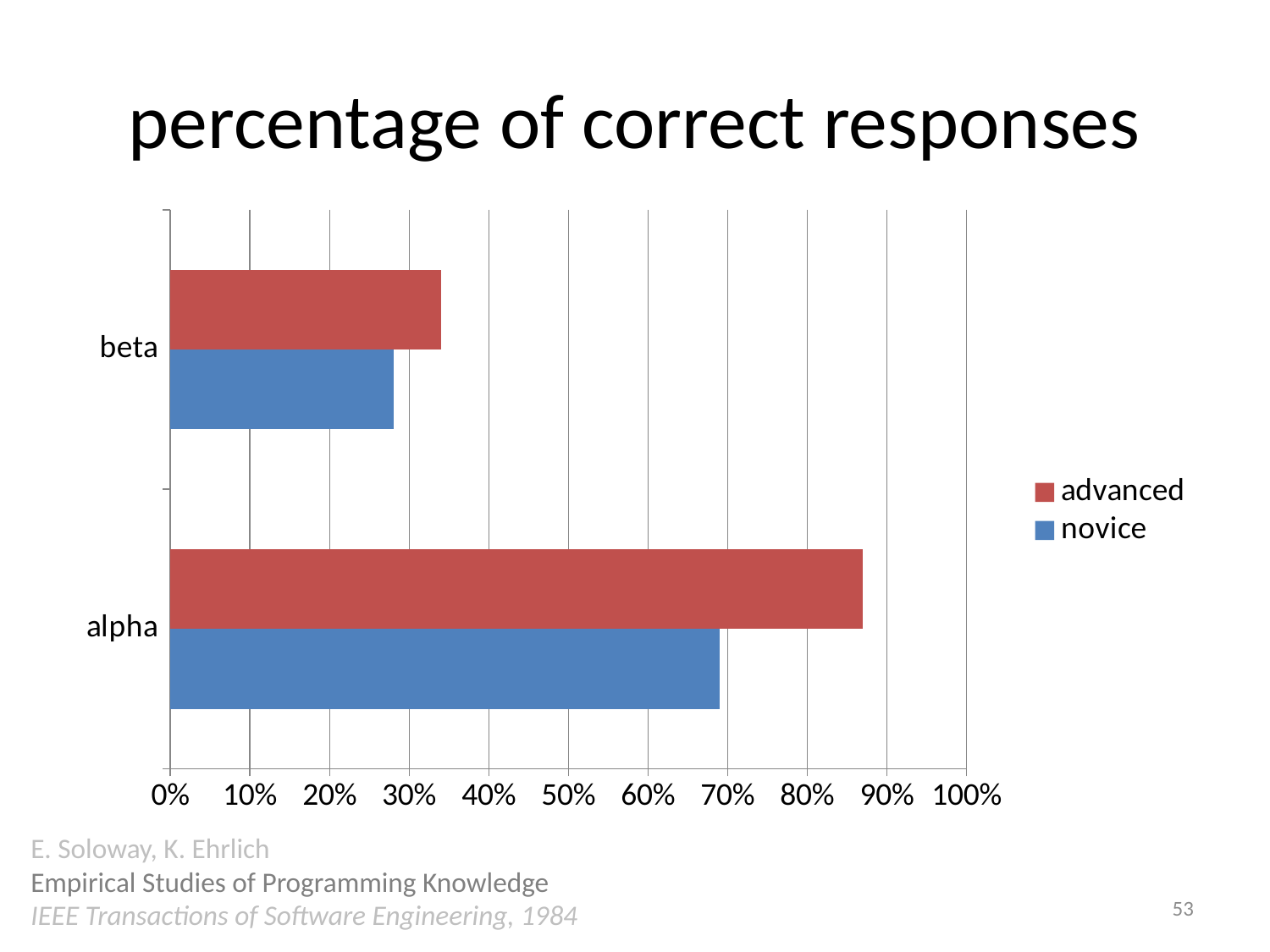
What kind of chart is shown on the slide? bar chart Is the novice value for alpha greater or less than 60%? greater For beta, which is larger: advanced or novice? advanced Is the novice value for beta greater or less than 40%? less Which category has the highest value for the advanced series? alpha Which category has the lowest value for the novice series? beta How many series does the legend list? 2 Which series is shown in red? advanced Is the advanced value for alpha greater or less than 80%? greater How many categories are shown on the vertical axis? 2 What is the title of the chart? percentage of correct responses For alpha, which is larger: advanced or novice? advanced